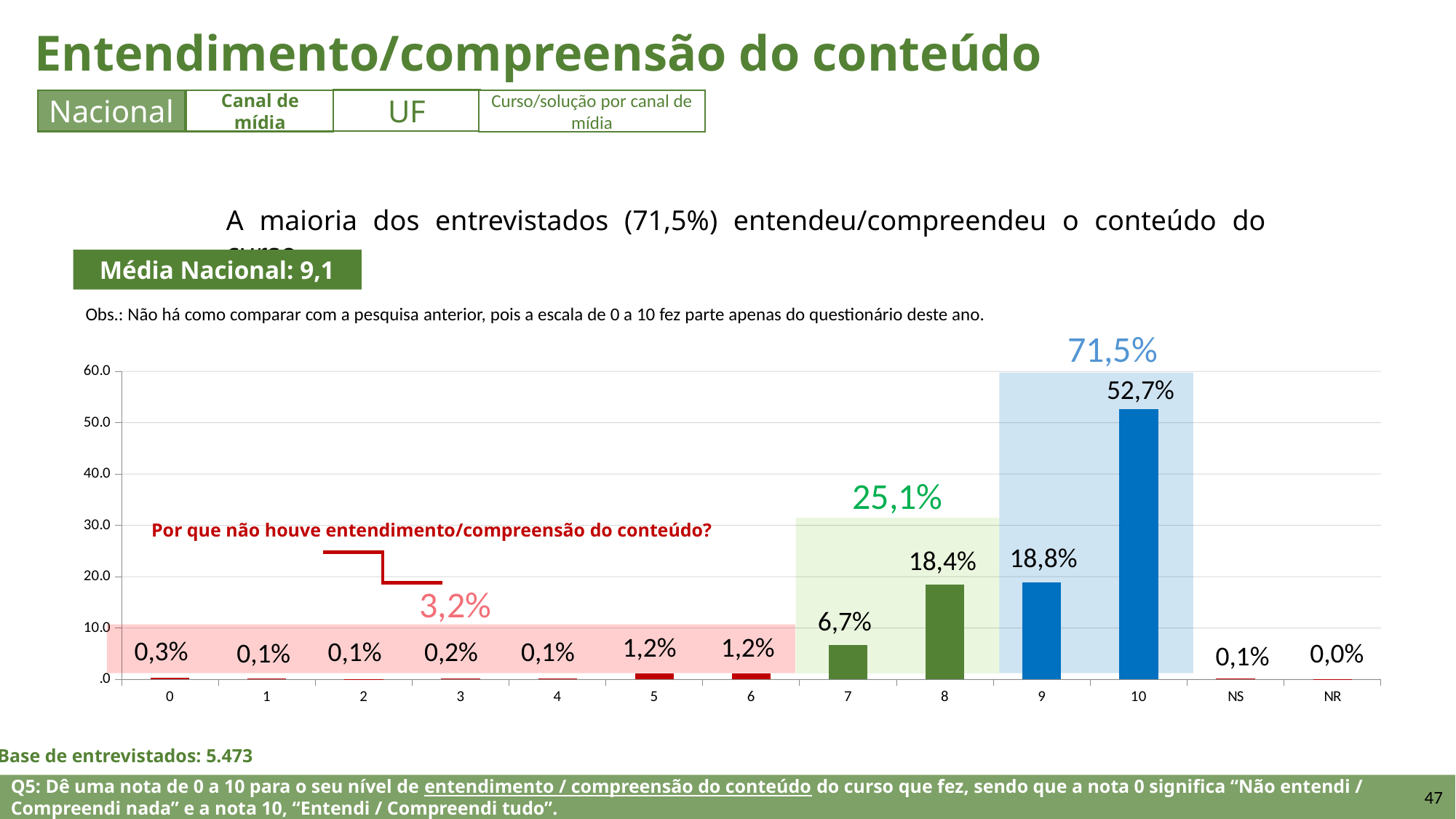
Which category has the lowest value? NR What is the value for score 8? 18,4% How many categories are shown on the x axis? 13 What is the difference between the values for score 10 and score 9? 33,9% What is the value for score 10? 52,7% What is the value for NS? 0,1% What combined percentage is shown for scores 9 and 10 together? 71,5% What kind of chart is shown on the slide? bar chart Which category has the highest value? 10 Which is larger, the value for score 7 or score 8? 8 Is the value for score 10 greater or less than 50.0? greater What is the value for score 7? 6,7%